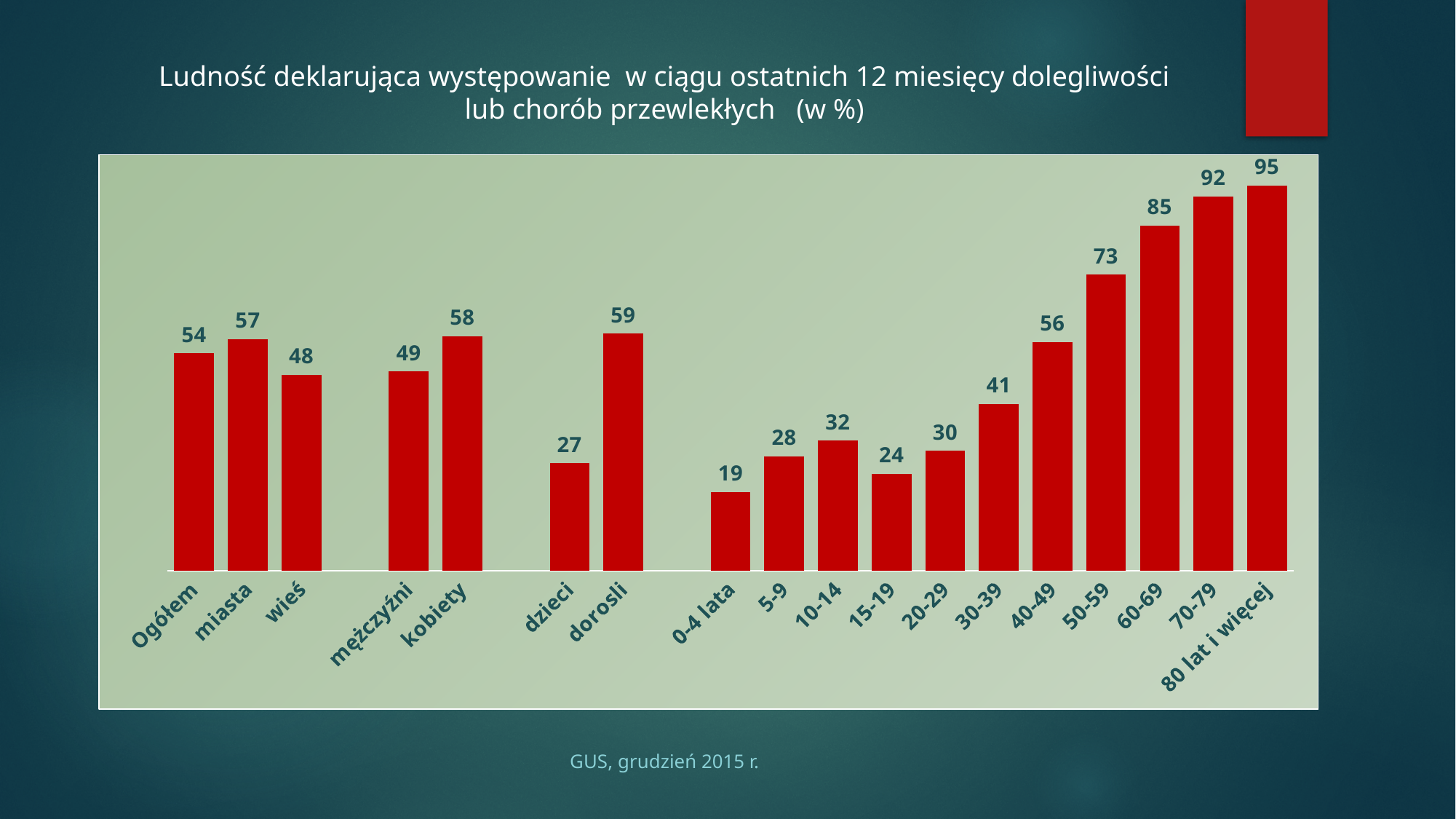
What kind of chart is shown on the slide? bar chart What is the value for '0-4 lata'? 19 What is the difference between the values for 'kobiety' and 'mężczyźni'? 9 What is the value for 'Ogółem'? 54 Which category has the lowest value? 0-4 lata Which category has the highest value? 80 lat i więcej What is the difference between the values for 'dorosli' and 'dzieci'? 32 Do the values rise or fall across the age groups from '20-29' to '80 lat i więcej'? rise How many bars are shown in the chart? 18 What colour are the bars in the chart? red What is the value for 'kobiety'? 58 Which is larger, the value for 'miasta' or the value for 'wieś'? miasta